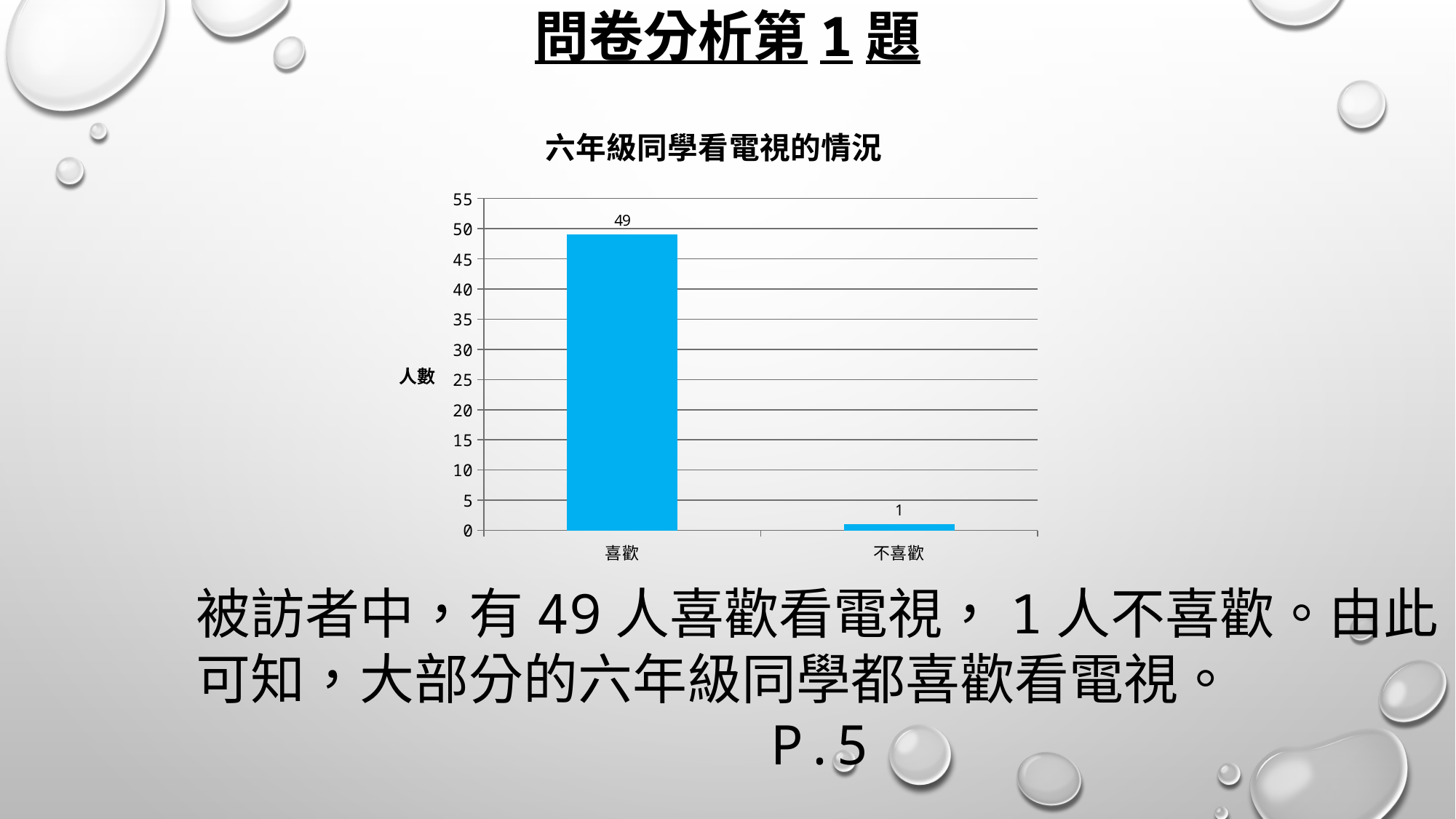
What is the title of the chart? 六年級同學看電視的情況 Is the value for 不喜歡 greater or less than 5? less Which is larger, the value for 喜歡 or the value for 不喜歡? 喜歡 What is the difference between the values for 喜歡 and 不喜歡? 48 What is the label of the vertical axis? 人數 Which category has the highest value? 喜歡 How many categories are shown on the x axis? 2 What is the value for 不喜歡? 1 What is the value for 喜歡? 49 Which category has the lowest value? 不喜歡 What kind of chart is shown on the slide? bar chart Is the value for 喜歡 greater or less than 45? greater